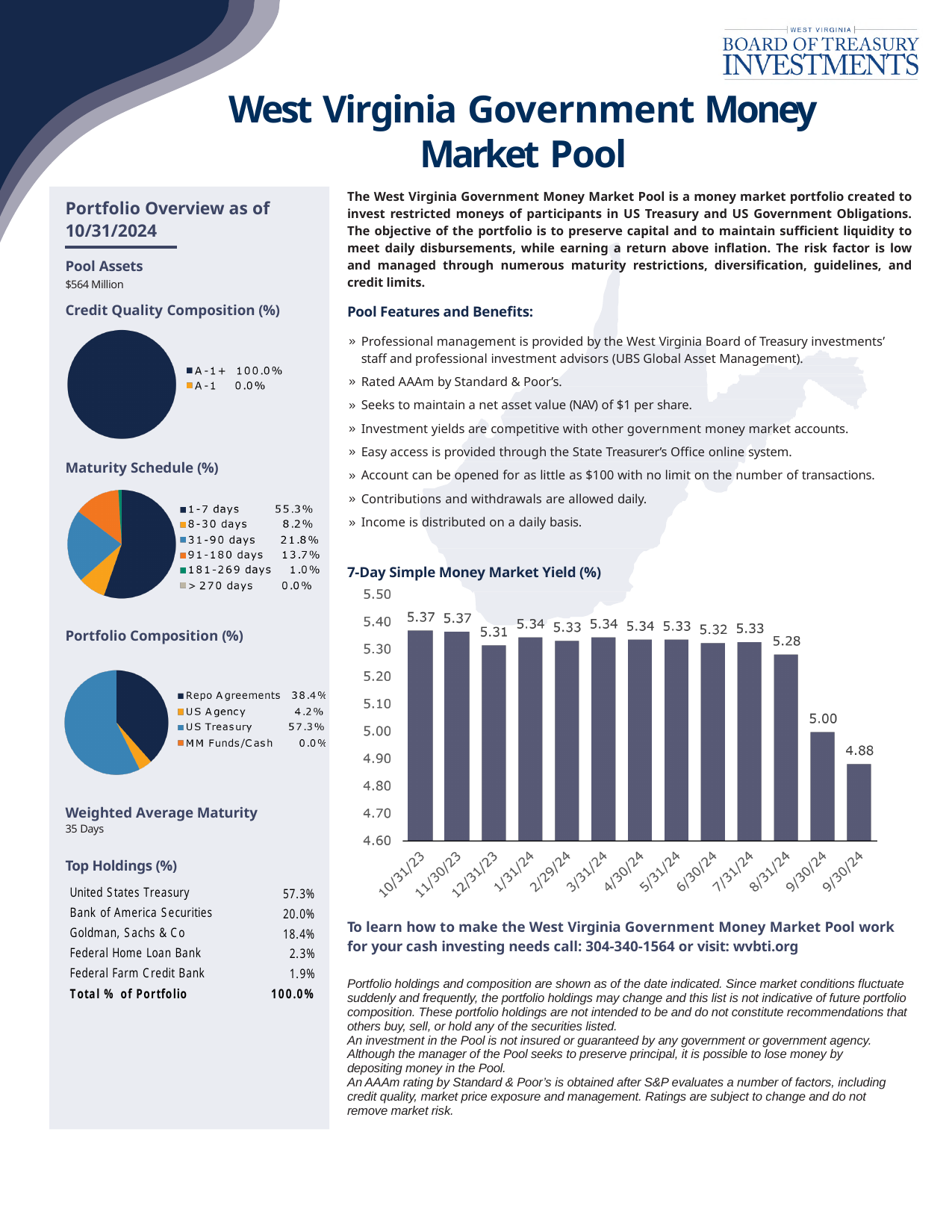
In the Credit Quality Composition (%) pie chart, what share is A-1+? 100.0% In the 7-Day Simple Money Market Yield (%) chart, what is the value for 8/31/24? 5.28 In the 7-Day Simple Money Market Yield (%) chart, what is the highest value shown? 5.37 In the 7-Day Simple Money Market Yield (%) chart, what is the value for 10/31/23? 5.37 What kind of chart is the 7-Day Simple Money Market Yield (%) chart? bar chart In the Portfolio Composition (%) pie chart, which is larger, US Treasury or Repo Agreements? US Treasury In the 7-Day Simple Money Market Yield (%) chart, what is the difference between the values for 10/31/23 and 8/31/24? 0.09 In the 7-Day Simple Money Market Yield (%) chart, what is the lowest value shown? 4.88 In the Maturity Schedule (%) pie chart, what is the value for 1-7 days? 55.3% In the 7-Day Simple Money Market Yield (%) chart, do the values generally rise or fall from left to right? fall How many bars are in the 7-Day Simple Money Market Yield (%) chart? 13 In the Maturity Schedule (%) pie chart, which category has the largest share? 1-7 days